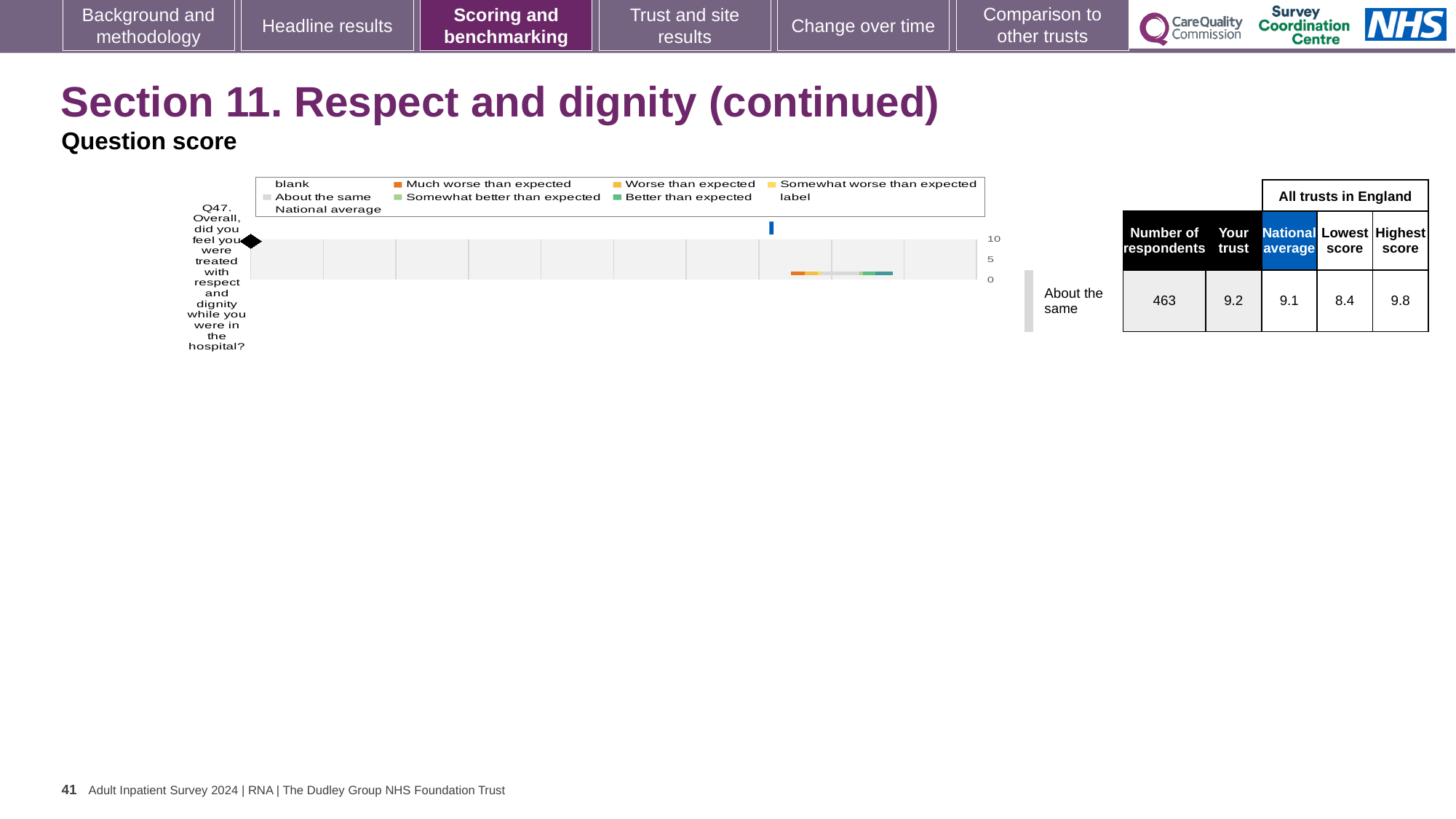
According to the table, how many respondents answered Q47? 463 What is the highest tick value shown on the chart's axis? 10 According to the table, what is the Lowest score among all trusts in England for Q47? 8.4 What benchmark category is the trust's Q47 score assigned to, as shown next to the chart? About the same Which is larger for Q47: the Your trust score or the National average score? Your trust Which survey question is plotted on the chart? Q47. Overall, did you feel you were treated with respect and dignity while you were in the hospital? According to the table, what is the score for Your trust for Q47? 9.2 According to the table, what is the National average score for Q47? 9.1 What is the difference between the Your trust score and the National average score for Q47? 0.1 What is the difference between the Highest score and the Lowest score in the table for Q47? 1.4 According to the table, what is the Highest score among all trusts in England for Q47? 9.8 What kind of chart is shown on the slide? bar chart